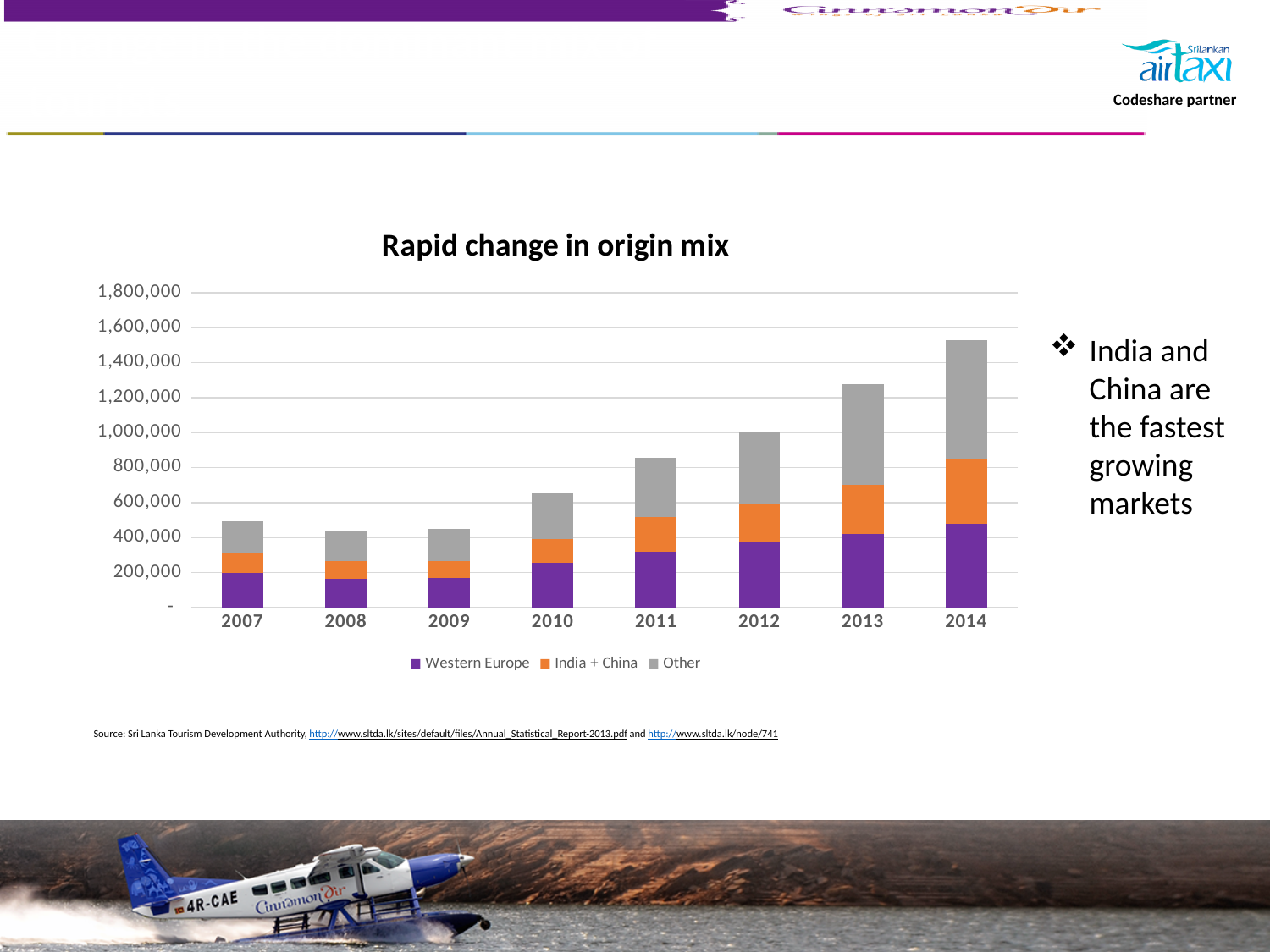
Is the total value for 2013 greater or less than 1,200,000? greater Do the total bar heights generally rise or fall from 2007 to 2014? Rise How many series does the legend list? 3 Which year has the larger total bar, 2011 or 2010? 2011 What is the title of the chart? Rapid change in origin mix What kind of chart is shown on the slide? Stacked bar chart Which year has the larger total bar, 2007 or 2014? 2014 Is the total value for 2014 greater or less than 1,400,000? greater Which year has the highest total bar in the chart? 2014 Is the total value for 2007 greater or less than 600,000? less How many years are shown on the x axis of the chart? 8 Which series is shown in purple in the chart? Western Europe